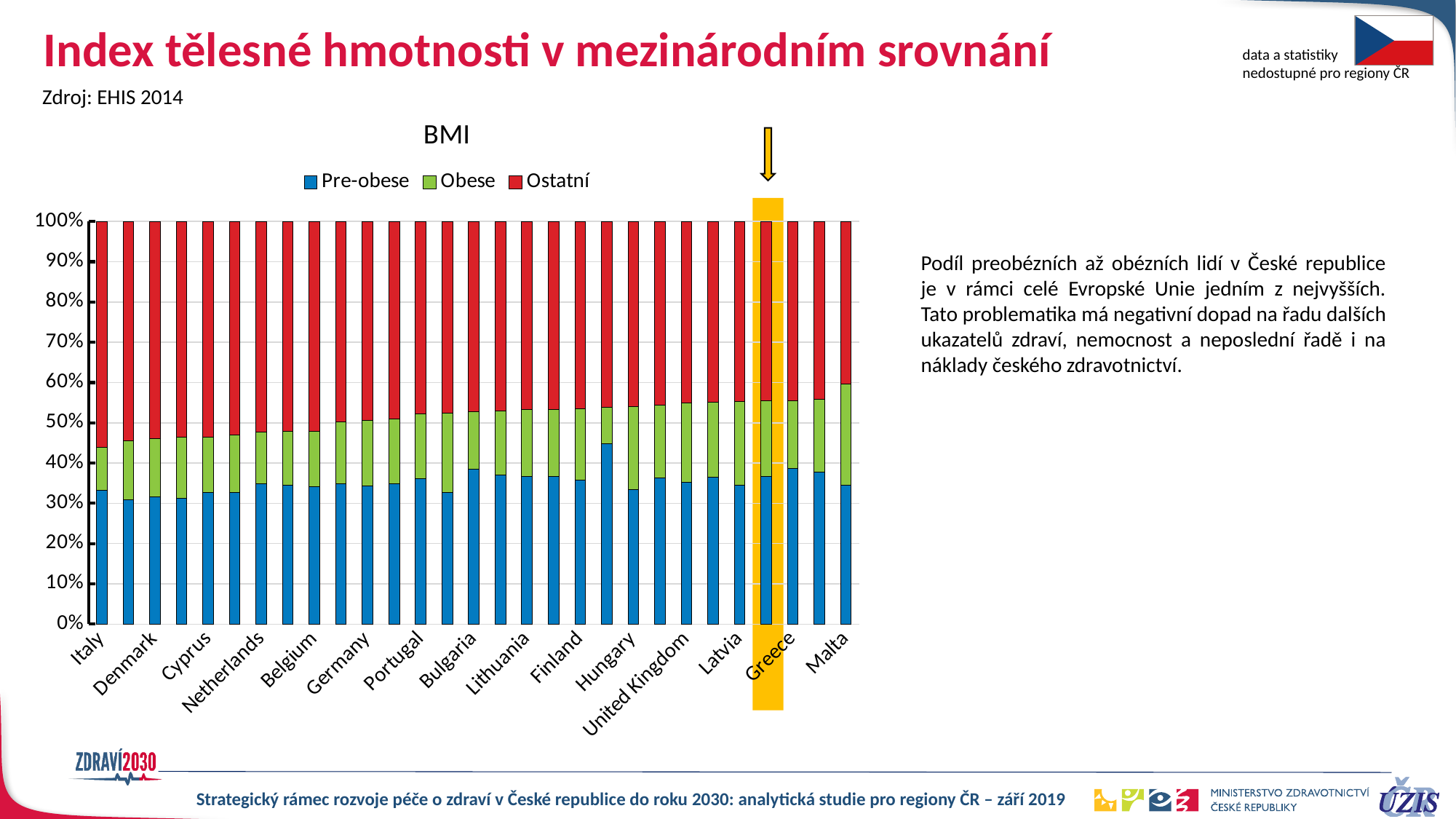
Is the Ostatní share for Malta greater or less than 50%? less Is the combined Pre-obese and Obese share for Malta greater or less than 50%? greater What kind of chart is shown on the slide? Stacked bar chart Which colour represents the Ostatní series in the BMI chart? Red Is the combined Pre-obese and Obese share for Italy greater or less than 50%? less Among the labelled countries, which has the largest Ostatní share? Italy What are the three series named in the legend of the BMI chart? Pre-obese, Obese, Ostatní How many series does the legend of the BMI chart list? 3 Does the combined Pre-obese and Obese share rise or fall from left to right across the countries? Rise